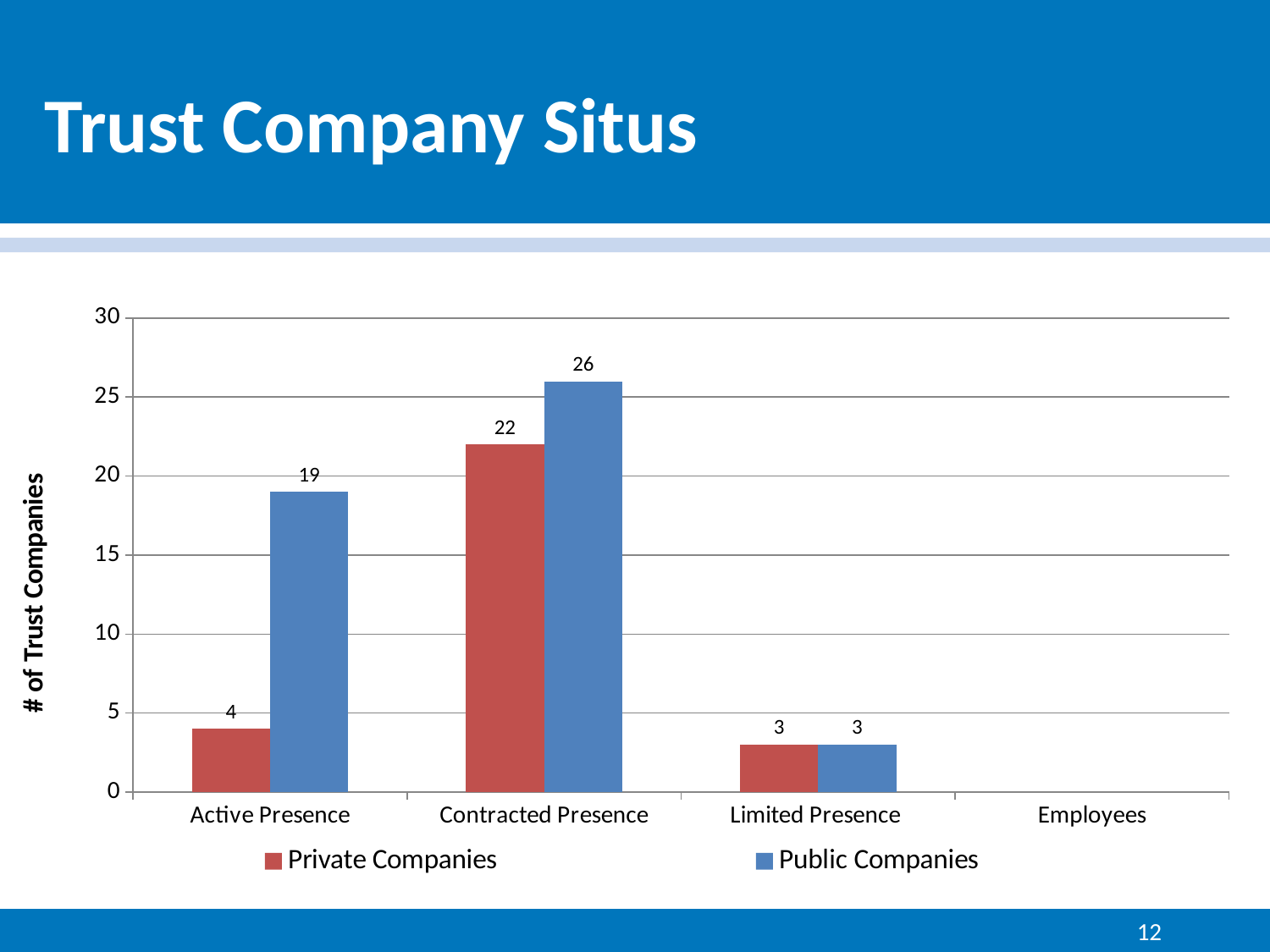
How many categories are shown on the x axis? 4 What is the difference between Public Companies and Private Companies in the Active Presence category? 15 What is the value for Public Companies in the Contracted Presence category? 26 Which category has the highest value for Private Companies? Contracted Presence Which is larger in the Contracted Presence category, Private Companies or Public Companies? Public Companies Which category has the lowest value for Public Companies? Limited Presence What is the value for Public Companies in the Active Presence category? 19 What is the label of the vertical axis? # of Trust Companies What is the difference between Public Companies and Private Companies in the Contracted Presence category? 4 What is the value for Private Companies in the Active Presence category? 4 What kind of chart is shown on the slide? Bar chart How many series does the legend list? 2